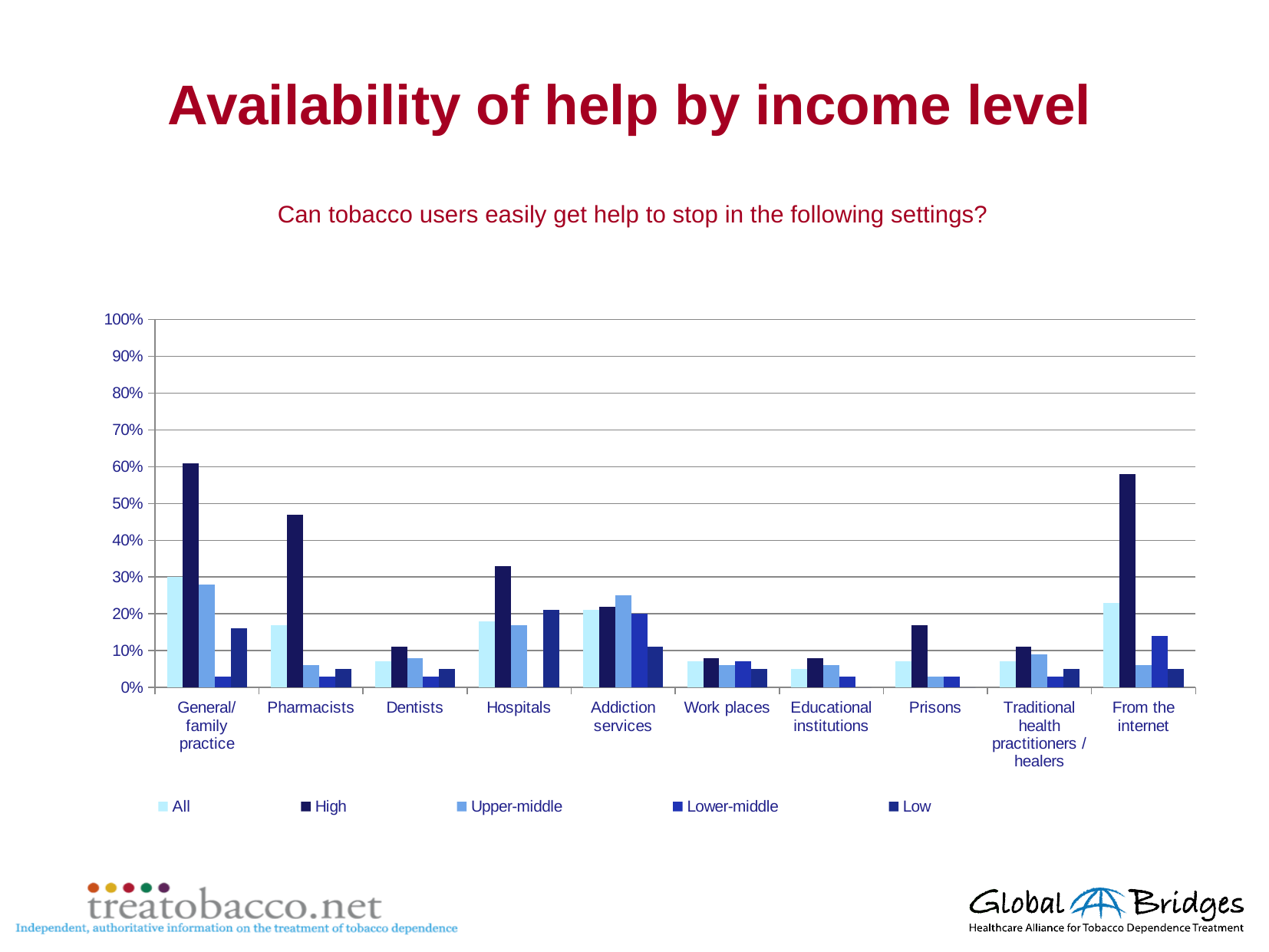
Which is larger: the Low value for Hospitals or the Low value for Pharmacists? Hospitals What question does the chart's subtitle ask? Can tobacco users easily get help to stop in the following settings? Which income-level series has the highest value for General/family practice? High How many settings (categories) are shown along the x axis? 10 How many series does the legend list? 5 Is the value for High at Pharmacists greater or less than 40%? greater Which income-level series has the highest value for Pharmacists? High What kind of chart is shown on the slide? bar chart Is the value for Low at General/family practice greater or less than 20%? less Which is larger: the High value for Hospitals or the High value for Prisons? Hospitals Is the value for High at From the internet greater or less than 50%? greater